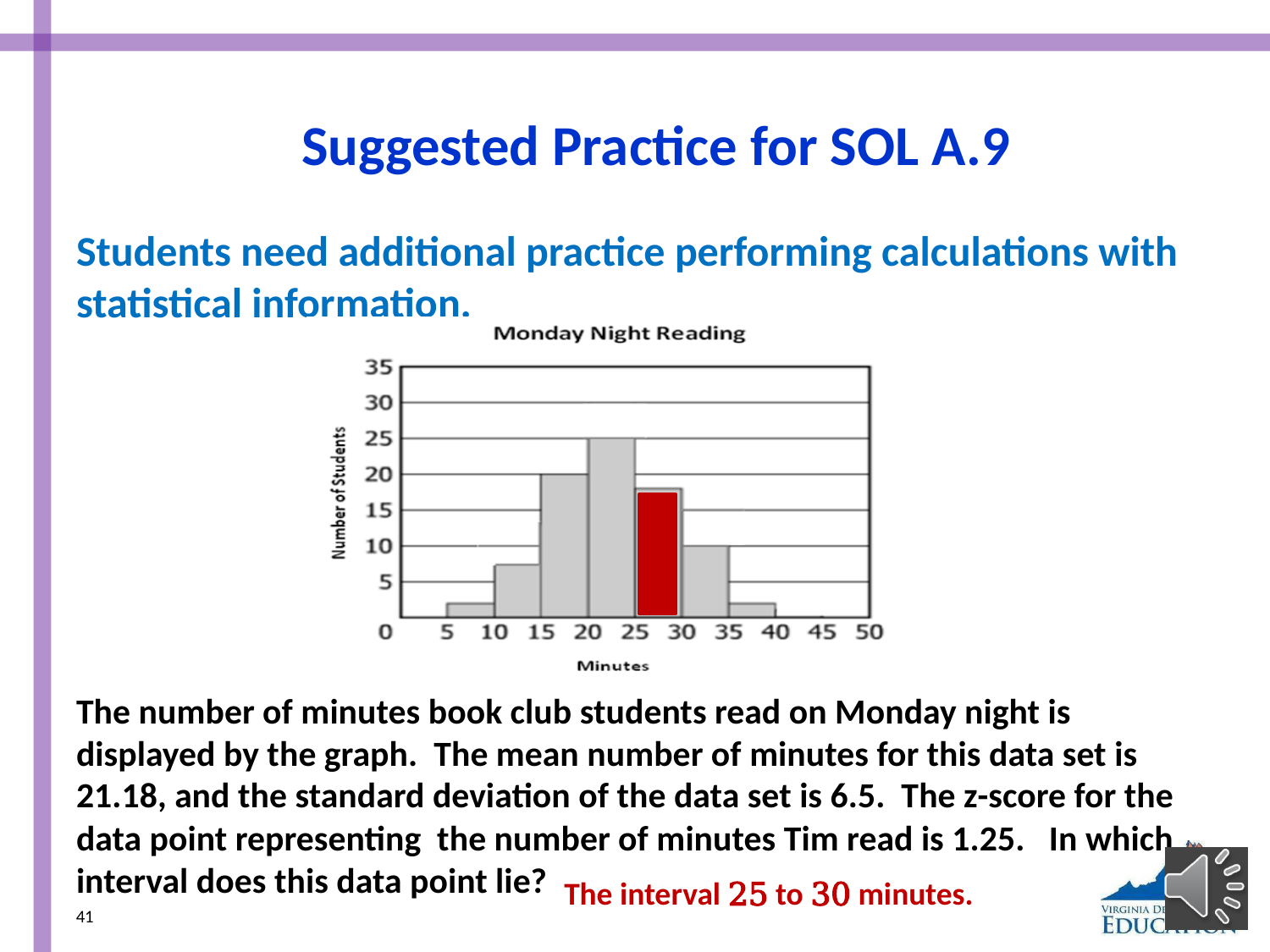
How many bars (intervals) are shown in the chart? 7 Is the number of students in the 10 to 15 minutes interval greater or less than 10? less How many students are in the 20 to 25 minutes interval? 25 How many students are in the 30 to 35 minutes interval? 10 How many students are in the 15 to 20 minutes interval? 20 Which interval is highlighted in red on the chart? 25 to 30 minutes What is the title of the chart? Monday Night Reading What is the difference in number of students between the 20 to 25 interval and the 15 to 20 interval? 5 Which interval of minutes has the highest number of students? 20 to 25 Is the number of students in the 25 to 30 minutes interval greater or less than 15? greater Which has more students, the 15 to 20 minutes interval or the 30 to 35 minutes interval? 15 to 20 What kind of chart is shown on the slide? bar chart